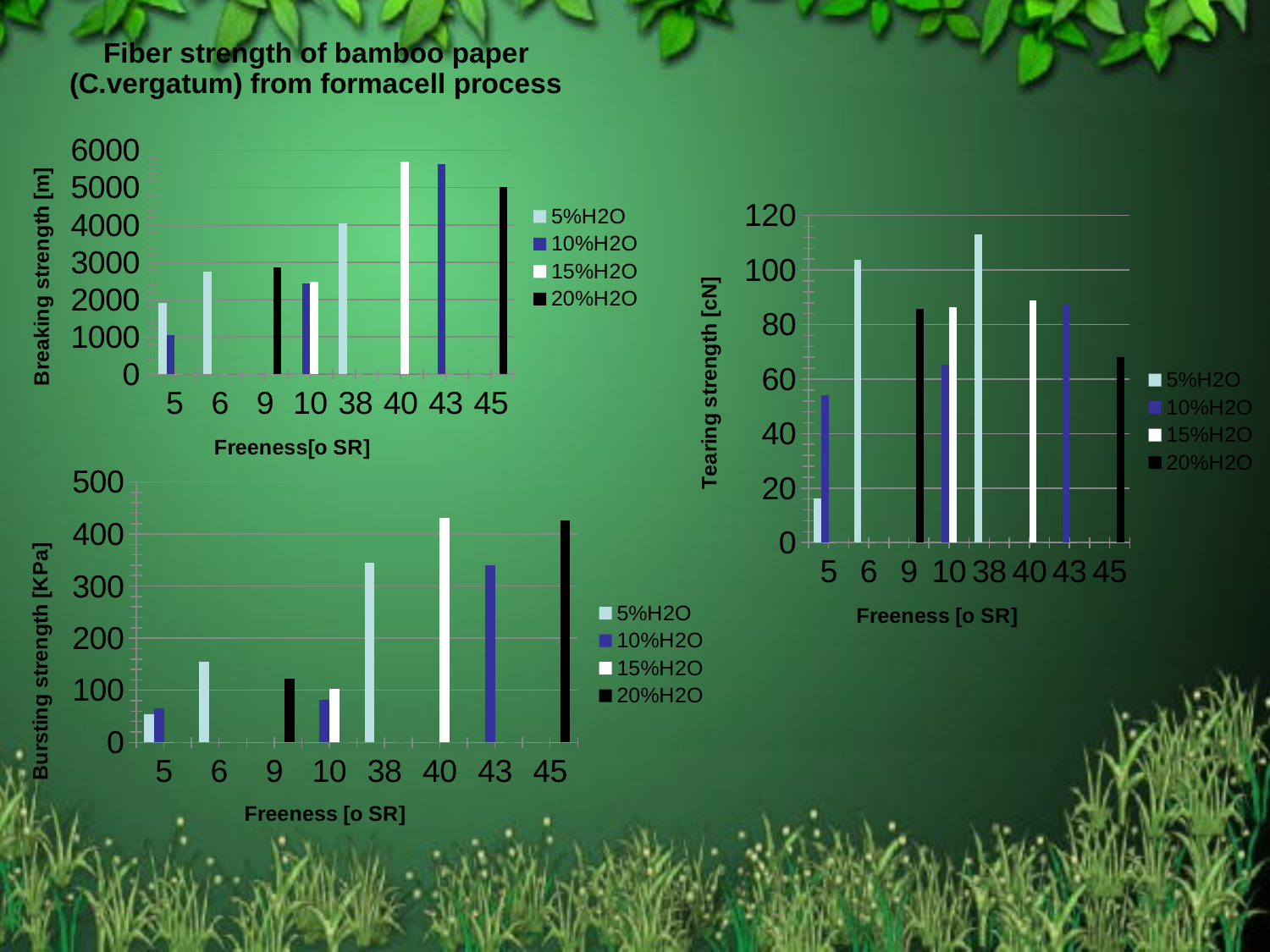
What kind of chart is the Breaking strength chart at the top left of the slide? bar chart In the Tearing strength chart on the right, which freeness category has the lowest bar? 5 How many freeness categories are shown on the x axis of the Bursting strength chart at the bottom left? 8 What is the y-axis label of the chart on the right side of the slide? Tearing strength [cN] In the Bursting strength chart at the bottom left, which is larger: the 5%H2O bar at freeness 38 or the 5%H2O bar at freeness 6? freeness 38 In the Tearing strength chart on the right, which freeness category has the highest bar? 38 In the Bursting strength chart at the bottom left, is the value for 15%H2O at freeness 40 greater or less than 400? greater How many series does the legend of the Tearing strength chart on the right list? 4 In the Bursting strength chart at the bottom left, is the value for 5%H2O at freeness 6 greater or less than 200? less In the Breaking strength chart at the top left, is the value for 10%H2O at freeness 5 greater or less than 2000? less